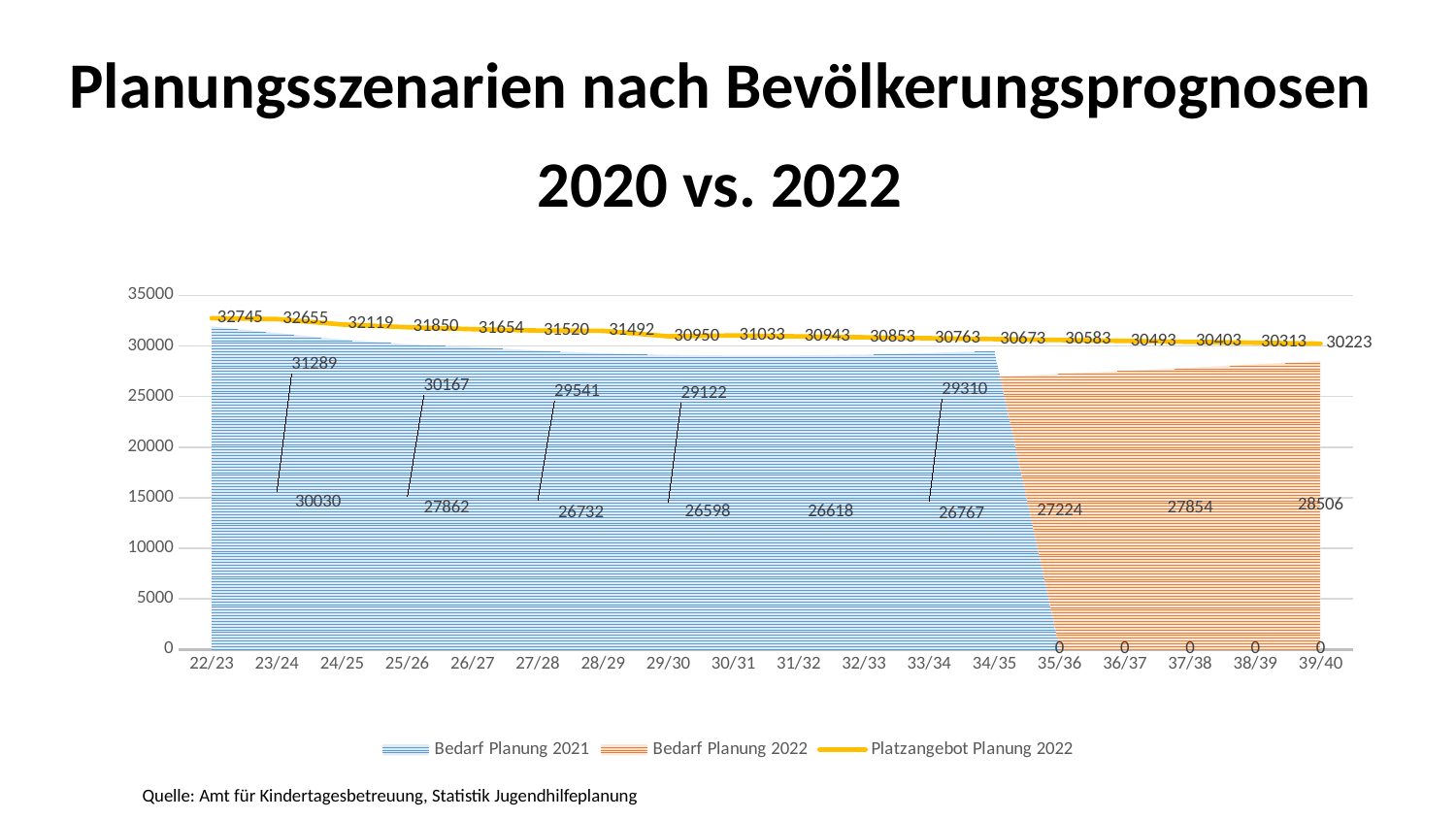
What are the three series named in the legend? Bedarf Planung 2021, Bedarf Planung 2022, Platzangebot Planung 2022 What is the value of Platzangebot Planung 2022 for 31/32? 30943 Does Platzangebot Planung 2022 rise or fall from 22/23 to 39/40? fall What is the value of Bedarf Planung 2021 for 36/37? 0 In which year is Platzangebot Planung 2022 lowest? 39/40 How many series does the legend list? 3 In which year is Platzangebot Planung 2022 highest? 22/23 What is the value of Platzangebot Planung 2022 for 22/23? 32745 What is the value of Bedarf Planung 2022 for 39/40? 28506 How many year categories are shown on the x axis? 18 What is the difference between Platzangebot Planung 2022 in 22/23 and in 39/40? 2522 What is the value of Platzangebot Planung 2022 for 39/40? 30223